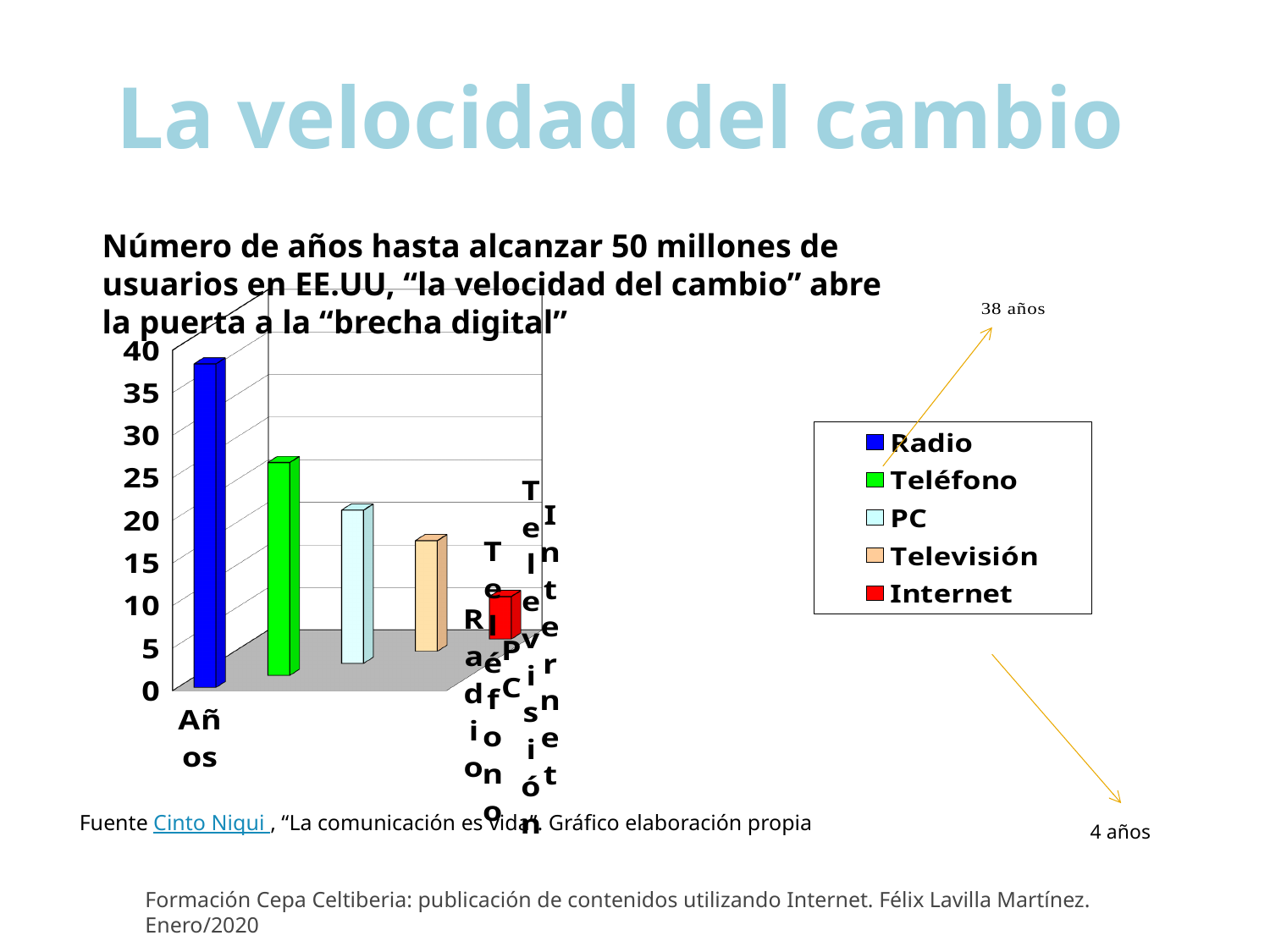
Which medium took the most years to reach 50 million users? Radio Which medium took the fewest years to reach 50 million users? Internet What kind of chart is shown on the slide? Bar chart Is the value for Teléfono greater or less than 20? greater What colour represents Internet in the legend? Red Which took more years to reach 50 million users, Teléfono or PC? Teléfono Is the value for Televisión greater or less than 20? less How many series does the legend list? 5 How many bars are plotted in the chart? 5 How many years did it take Internet to reach 50 million users, according to the annotation on the chart? 4 años How many years did it take radio to reach 50 million users, according to the annotation on the chart? 38 años